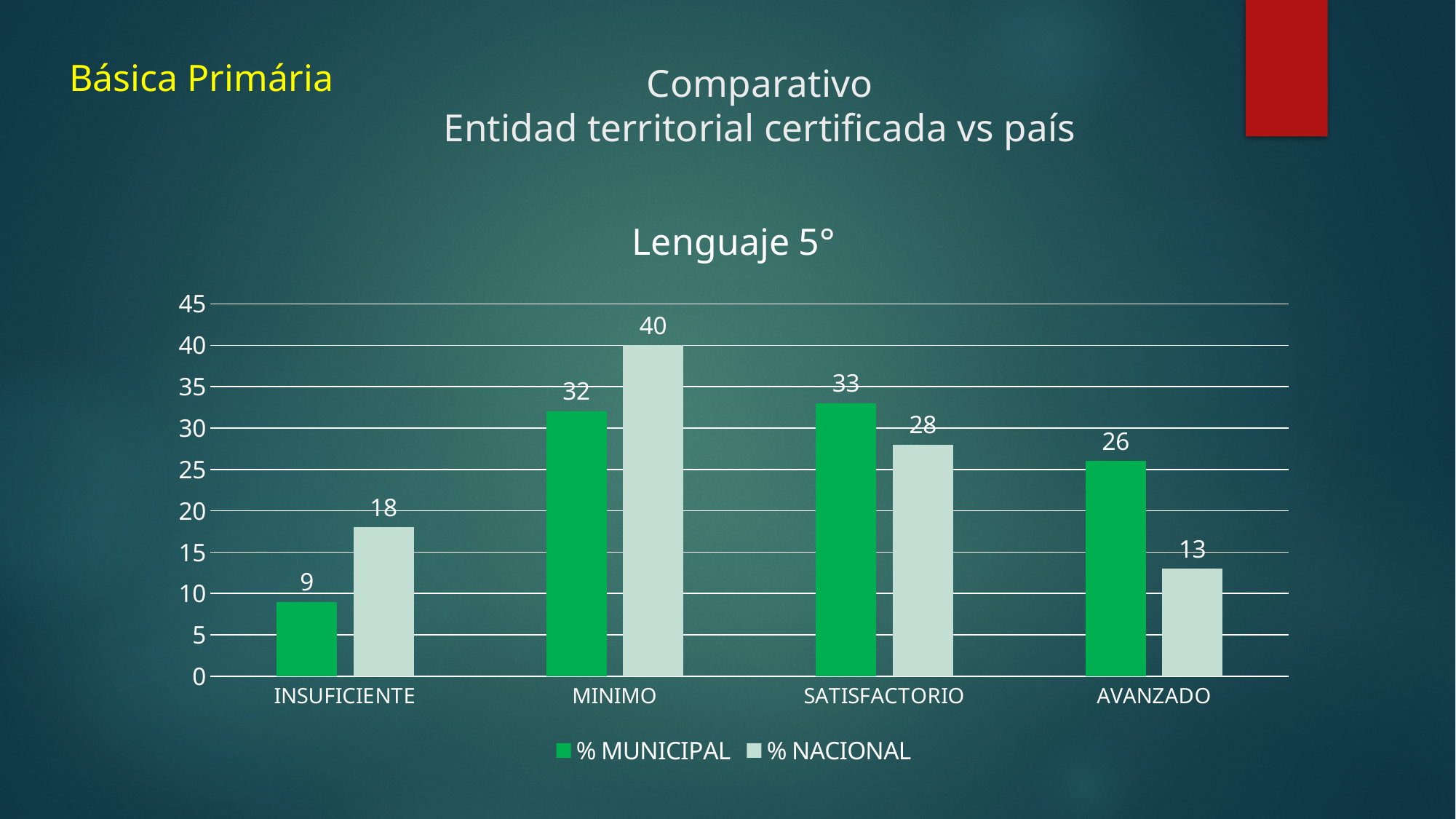
Which category has the highest % NACIONAL value? MINIMO What is the % MUNICIPAL value for AVANZADO? 26 What is the difference between the % MUNICIPAL and % NACIONAL values for AVANZADO? 13 What is the title of the chart? Lenguaje 5° For SATISFACTORIO, which series has the larger value, % MUNICIPAL or % NACIONAL? % MUNICIPAL What kind of chart is shown on the slide? Bar chart What is the difference between the % NACIONAL and % MUNICIPAL values for INSUFICIENTE? 9 How many categories are shown on the x axis? 4 What is the % NACIONAL value for MINIMO? 40 Which category has the lowest % MUNICIPAL value? INSUFICIENTE What is the % MUNICIPAL value for INSUFICIENTE? 9 How many series does the legend list? 2